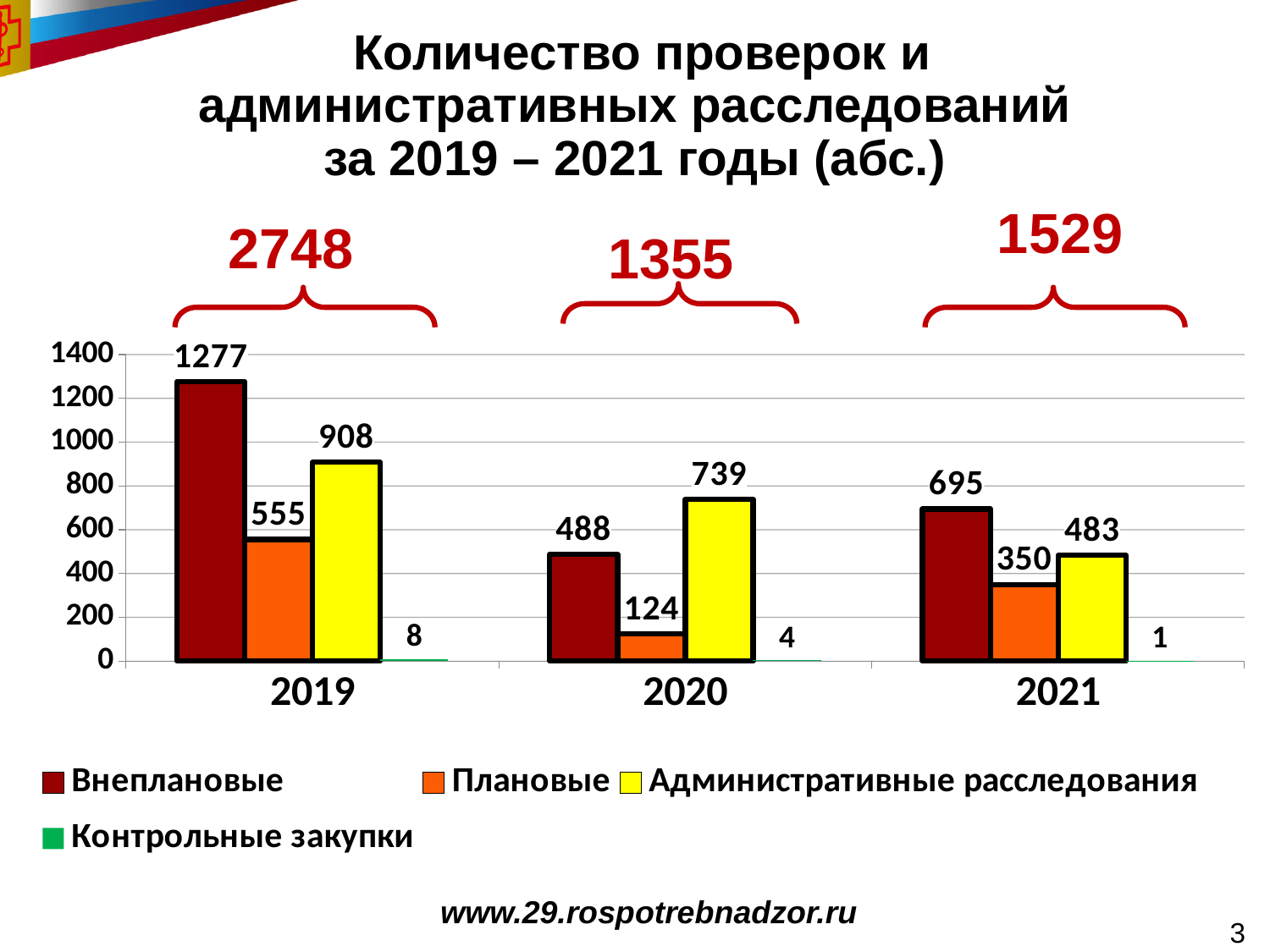
In which year is the value for Плановые the lowest? 2020 What is the value for Контрольные закупки in 2020? 4 What is the value for Административные расследования in 2021? 483 How many series does the legend list? 4 What total is shown above the 2021 group of bars? 1529 What is the value for Внеплановые in 2019? 1277 What is the value for Плановые in 2020? 124 In which year is the value for Внеплановые the highest? 2019 What kind of chart is shown on the slide? Bar chart How many years are shown on the x axis? 3 What is the difference between the Внеплановые values for 2019 and 2021? 582 Which is larger in 2020: Внеплановые or Административные расследования? Административные расследования